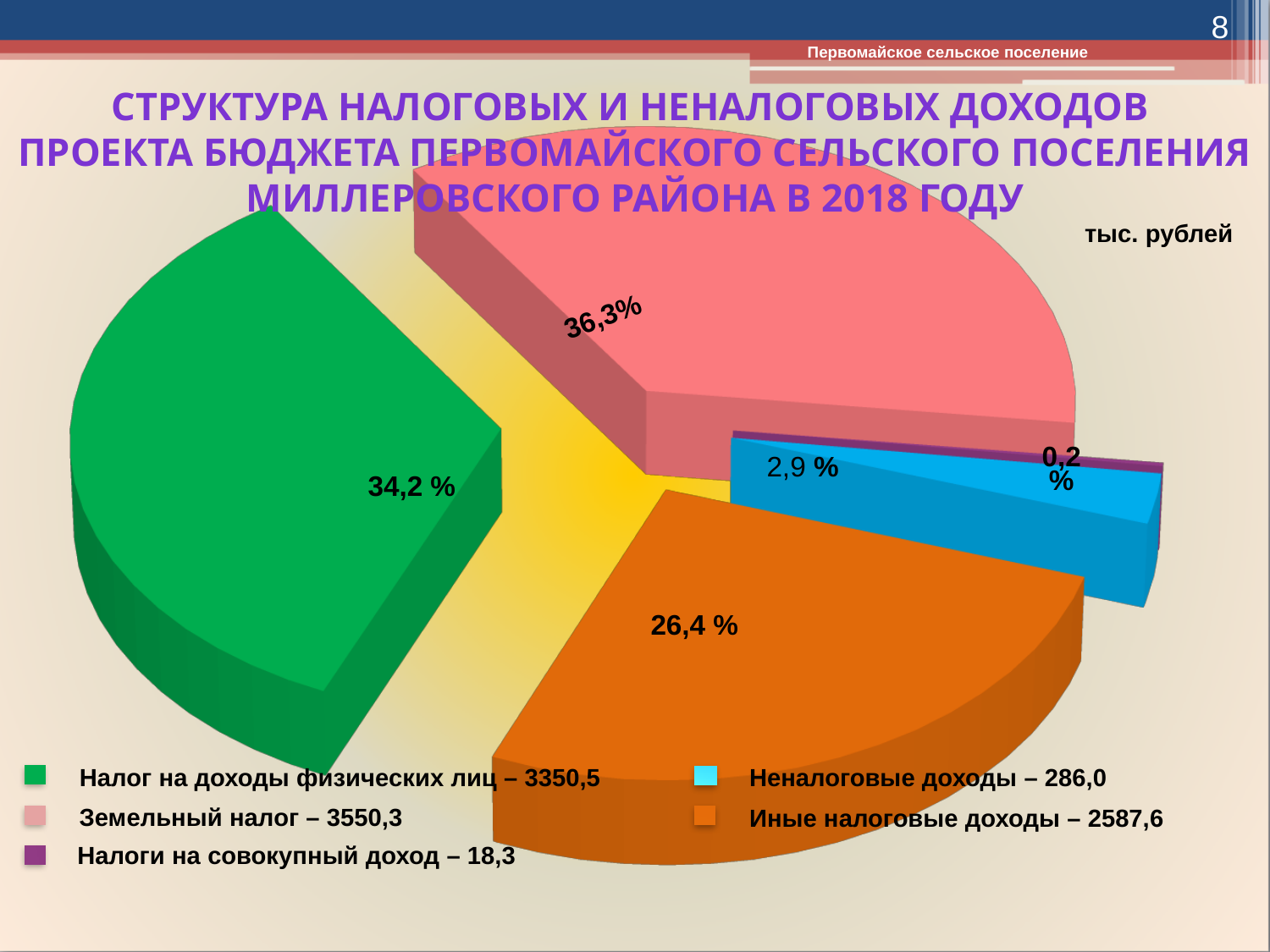
What share of the pie does Земельный налог represent? 36,3% What is the difference between the values for Земельный налог and Налог на доходы физических лиц? 199,8 How many slices does the pie chart have? 5 What is the value for Земельный налог in the legend? 3550,3 What kind of chart is shown on the slide? pie chart What colour is the slice for Иные налоговые доходы? orange What share of the pie does Неналоговые доходы represent? 2,9 % Which category has the largest share of the pie? Земельный налог Which category has the smallest share of the pie? Налоги на совокупный доход What share of the pie does Иные налоговые доходы represent? 26,4 % What is the value for Налоги на совокупный доход in the legend? 18,3